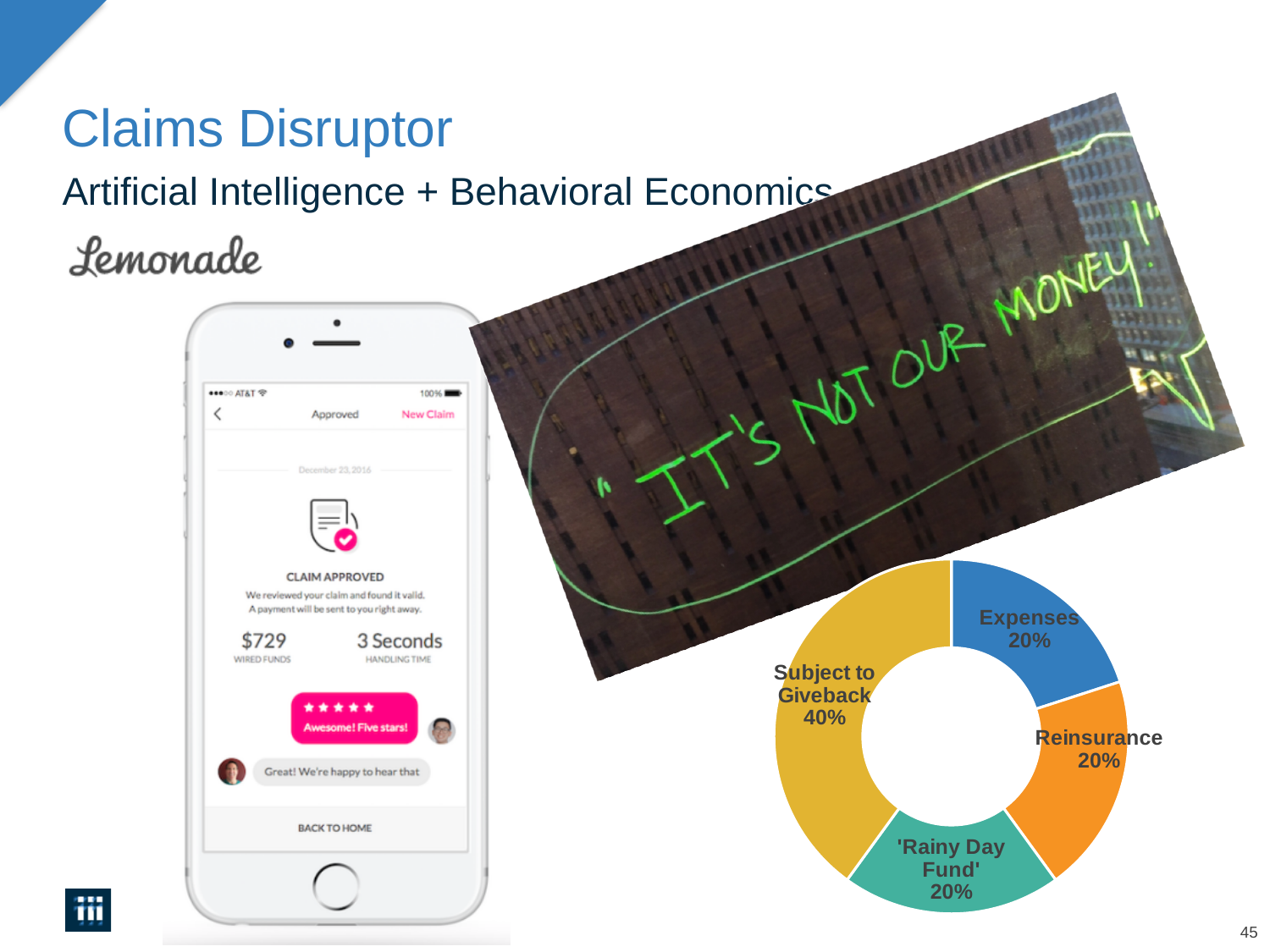
What percentage is shown for the 'Rainy Day Fund' slice? 20% What colour is the Subject to Giveback slice in the pie chart? Yellow Which is larger in the pie chart, Subject to Giveback or Reinsurance? Subject to Giveback How many slices does the pie chart have? 4 What colour is the Expenses slice in the pie chart? Blue Which slice of the pie chart is the largest? Subject to Giveback What is the combined share of Expenses, Reinsurance and 'Rainy Day Fund' in the pie chart? 60% What percentage is shown for Reinsurance in the pie chart? 20% What share of the pie chart is labelled 'Subject to Giveback'? 40% What percentage is shown for Expenses in the pie chart? 20% What kind of chart is shown on the slide? Pie chart (donut) What is the difference between the Subject to Giveback share and the Expenses share? 20%